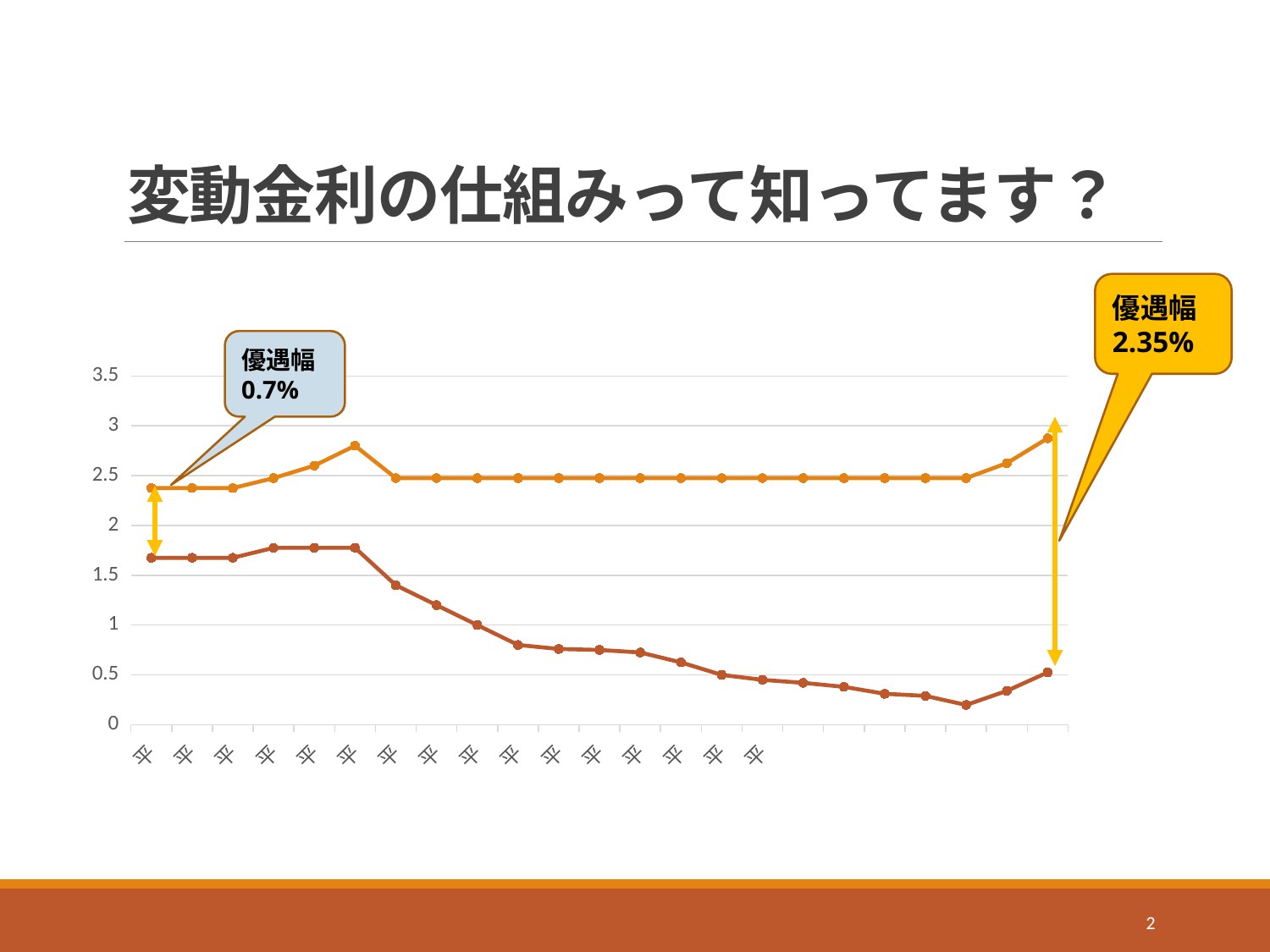
At the last data point, which line has the larger value, the upper orange line or the lower brown line? the upper orange line Is the highest point of the upper (orange) line greater or less than 2.5? greater What 優遇幅 (preferential margin) value is shown in the callout at the right of the chart? 2.35% Is the value of the lower (brown) line at its first point greater or less than 1.5? greater What kind of chart is shown on the slide? line chart How many lines (series) are plotted on the chart? 2 What 優遇幅 (preferential margin) value is shown in the callout at the left of the chart? 0.7% Does the lower (brown) line overall rise or fall from left to right? fall How many data points does each line on the chart have? 23 Is the value of the upper (orange) line at its first point greater or less than 2? greater